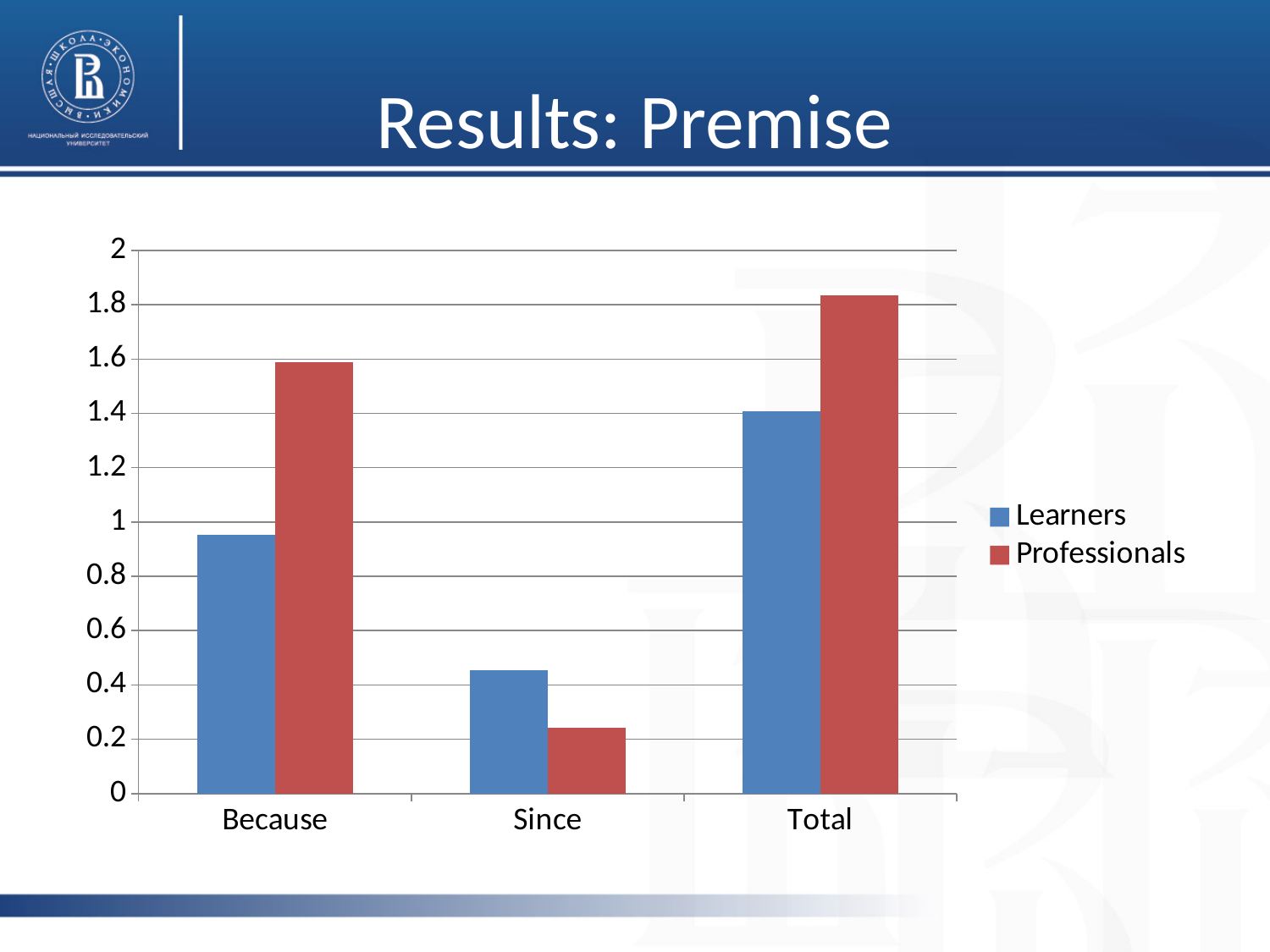
Is the value for Learners in the Because category greater or less than 1? less Which category has the lowest value for Professionals? Since Which category has the lowest value for Learners? Since Which category has the highest value for Professionals? Total Is the value for Professionals in the Because category greater or less than 1.4? greater What kind of chart is shown on the slide? bar chart How many categories are shown on the x axis? 3 For the Since category, which series has the larger value, Learners or Professionals? Learners For the Because category, which series has the larger value, Learners or Professionals? Professionals What is the title of the slide containing the chart? Results: Premise How many series does the legend list? 2